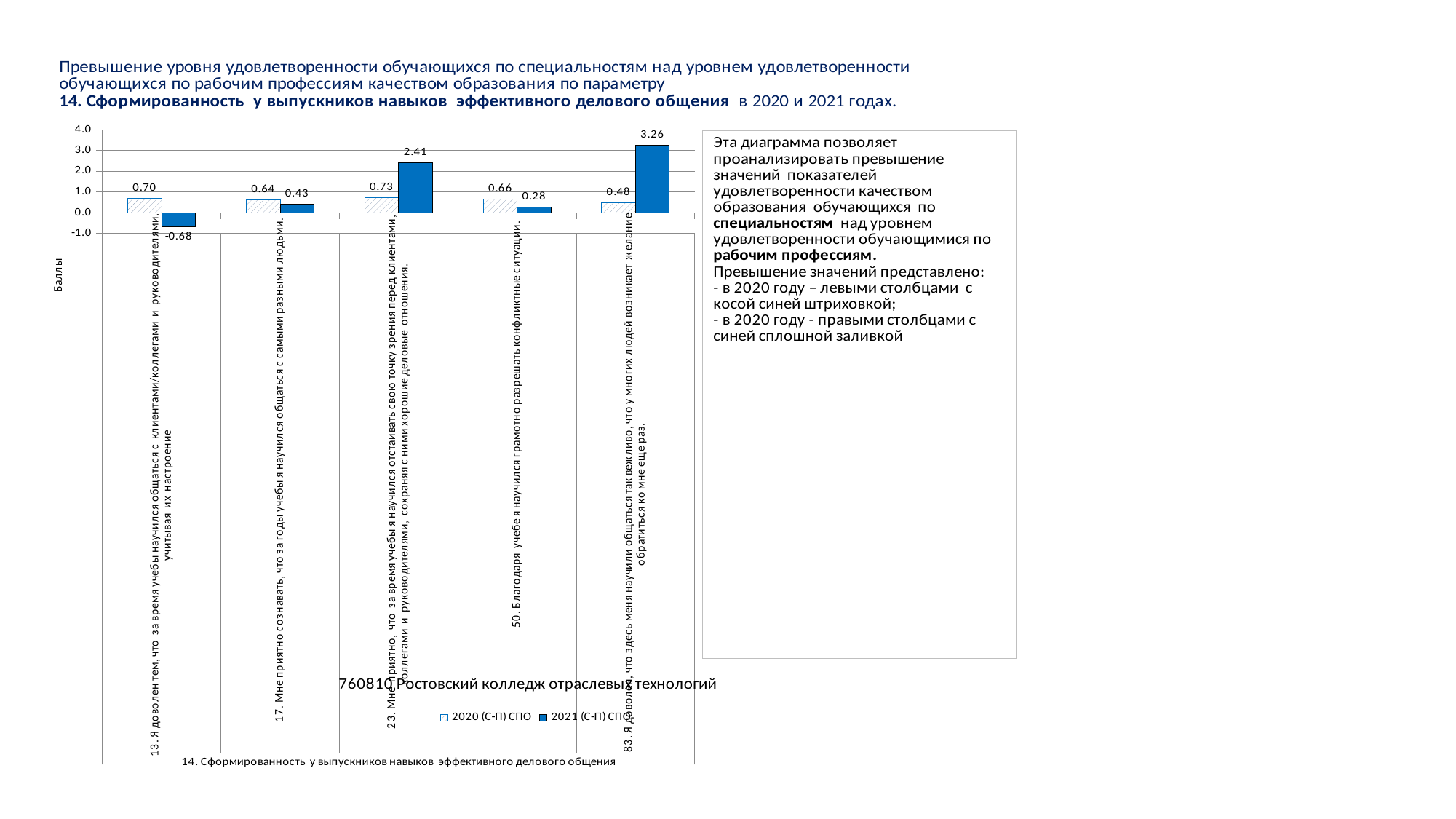
What is the difference between the 2021 and 2020 values for statement 23? 1.68 Which statement has the lowest 2020 (С-П) СПО value? 83 For statement 50, which is larger: the 2020 (С-П) СПО value or the 2021 (С-П) СПО value? 2020 (С-П) СПО What is the label of the y axis? Баллы What is the 2021 (С-П) СПО value for statement 13? -0.68 What is the 2020 (С-П) СПО value for statement 13 ("Я доволен тем, что за время учебы научился общаться с клиентами/коллегами и руководителями...")? 0.70 Which statement has the lowest 2021 (С-П) СПО value? 13 How many categories (statements) are plotted on the x axis? 5 What is the 2021 (С-П) СПО value for statement 83 ("Я доволен, что здесь меня научили общаться так вежливо...")? 3.26 Which statement has the highest 2021 (С-П) СПО value? 83 What type of chart is shown on the slide? bar chart How many series does the legend list? 2